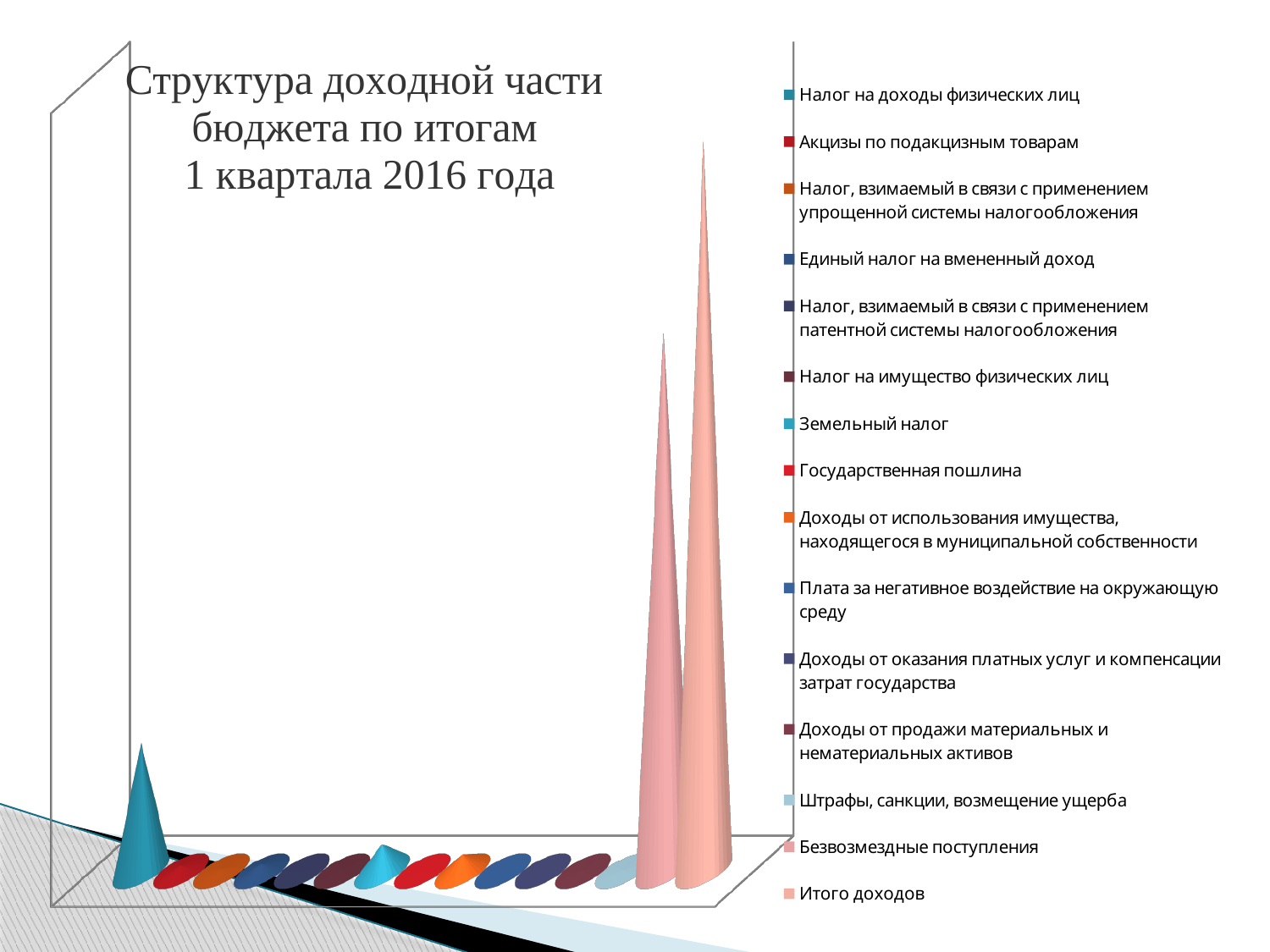
Which legend entry is listed first in the chart's legend? Налог на доходы физических лиц Which is larger, the bar for Налог на доходы физических лиц or the bar for Земельный налог? Налог на доходы физических лиц Which is larger, the bar for Итого доходов or the bar for Безвозмездные поступления? Итого доходов How many entries does the chart's legend list? 15 Which is larger, the bar for Безвозмездные поступления or the bar for Налог на доходы физических лиц? Безвозмездные поступления What is the title of the chart? Структура доходной части бюджета по итогам 1 квартала 2016 года Which legend entry has the tallest bar? Итого доходов Which legend entry has the second tallest bar? Безвозмездные поступления What kind of chart is shown on the slide? bar chart How many bars are plotted in the chart? 15